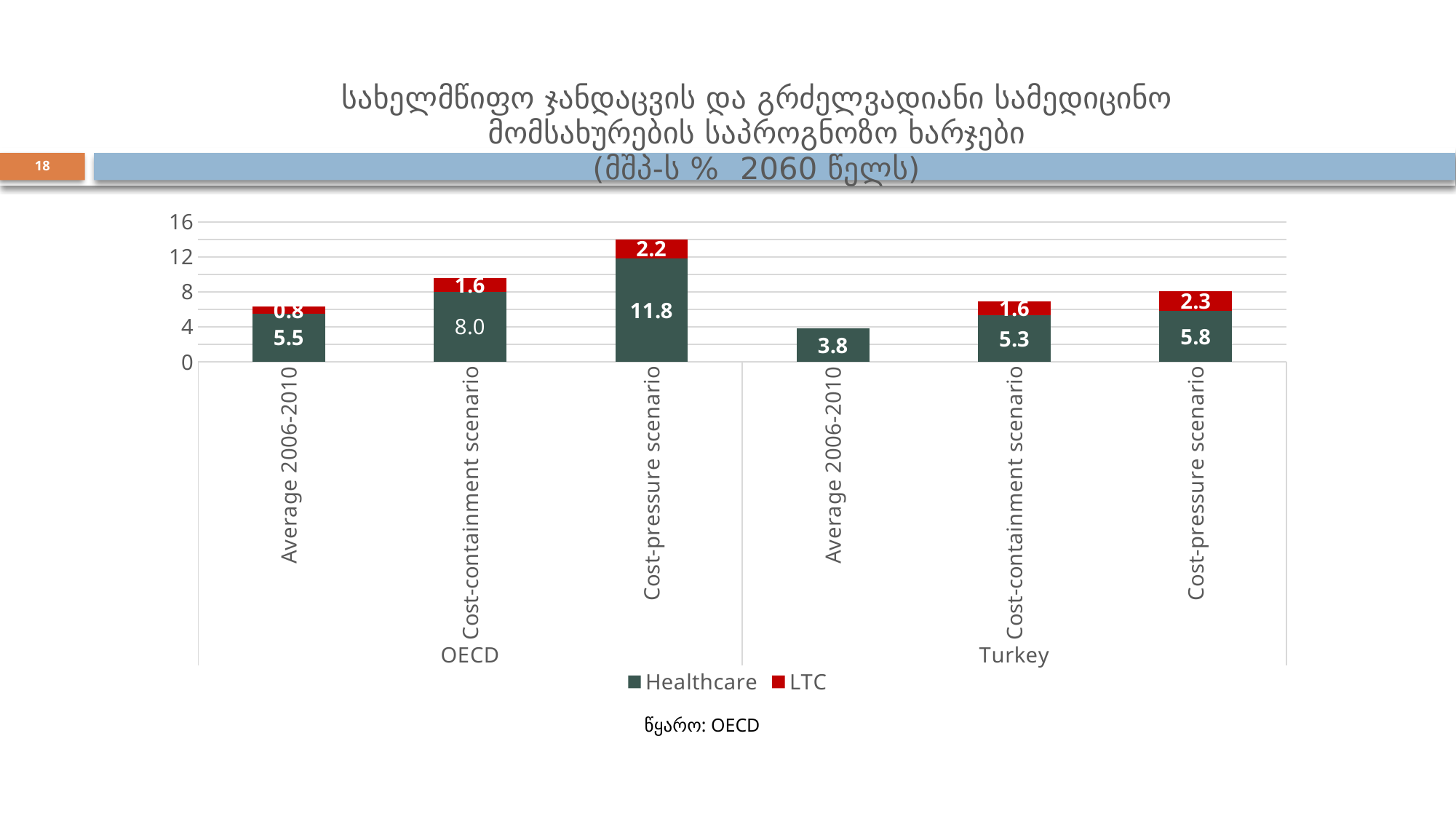
What kind of chart is shown on the slide? Stacked bar chart What is the Healthcare value for the OECD Cost-pressure scenario? 11.8 What is the LTC value for the Turkey Cost-pressure scenario? 2.3 Which category has the lowest Healthcare value? Turkey Average 2006-2010 How many series does the legend list? 2 What is the total of the stacked bar for the Turkey Cost-pressure scenario? 8.1 Which is larger, the Healthcare value for the Turkey Cost-pressure scenario or the Turkey Cost-containment scenario? Turkey Cost-pressure scenario Which category has the highest Healthcare value? OECD Cost-pressure scenario What is the Healthcare value for Turkey's Average 2006-2010? 3.8 What is the total of the stacked bar for the OECD Cost-containment scenario? 9.6 What is the LTC value for the OECD Average 2006-2010? 0.8 What is the difference between the Healthcare values for the OECD Cost-pressure scenario and the OECD Cost-containment scenario? 3.8